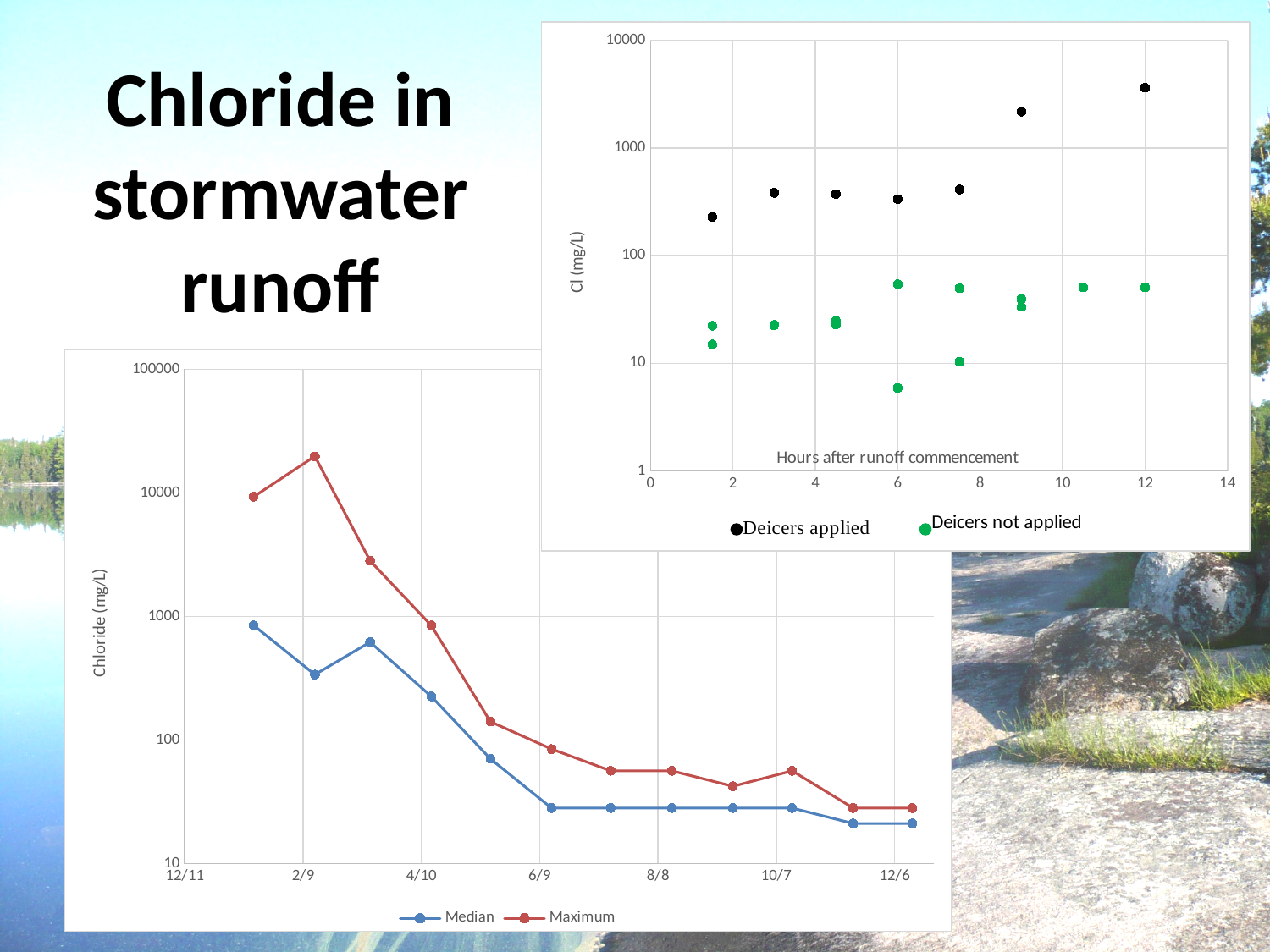
What kind of chart is the bottom chart with the Median and Maximum series? line chart What is the y-axis label of the bottom line chart? Chloride (mg/L) In the top-right scatter chart, is the lowest Deicers not applied value at 6 hours greater or less than 10? less In the bottom line chart, do the Median values generally rise or fall from 2/9 to 12/6? fall In the bottom line chart, how many series does the legend list? 2 What kind of chart is the top-right chart plotting Cl (mg/L) against hours after runoff commencement? scatter chart In the top-right scatter chart, is the Deicers applied value at 12 hours greater or less than 1000? greater In the bottom line chart, is the peak value of the Maximum series near 2/9 greater or less than 10000? greater In the bottom line chart, which series is larger at 4/10, Median or Maximum? Maximum In the top-right scatter chart, which series has the larger value at 9 hours, Deicers applied or Deicers not applied? Deicers applied In the top-right scatter chart, how many series does the legend list? 2